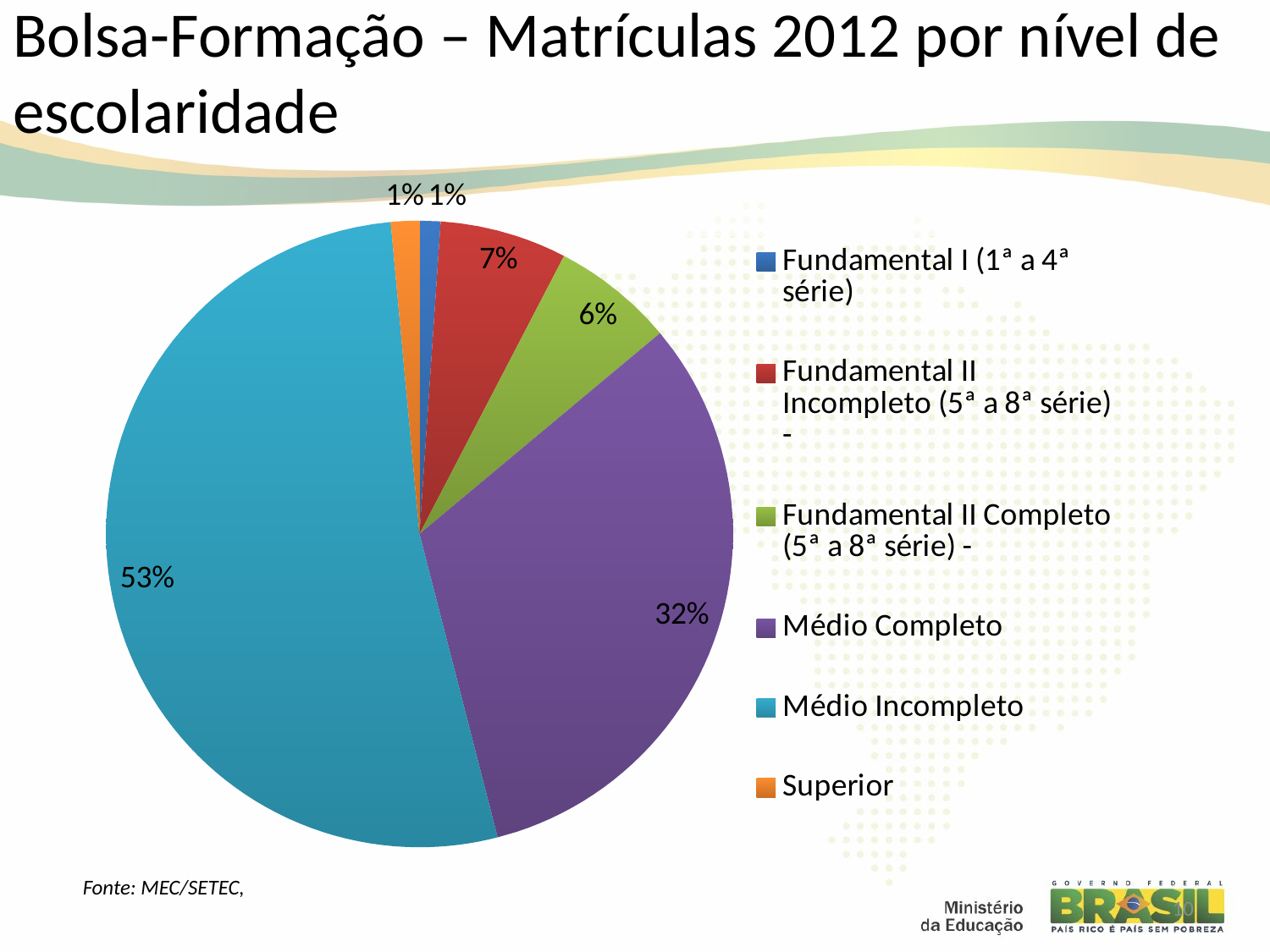
What is the combined share of Médio Completo and Médio Incompleto? 85% What is the difference in percentage points between Médio Incompleto and Médio Completo? 21 What is the value shown for Superior? 1% Which category has the largest slice of the pie? Médio Incompleto What share of the pie does Médio Completo represent? 32% What is the value shown for Fundamental II Completo (5ª a 8ª série)? 6% What kind of chart is shown on the slide? pie chart What colour is the slice for Médio Completo? purple What is the value shown for Fundamental II Incompleto (5ª a 8ª série)? 7% What share of the pie does Médio Incompleto represent? 53% How many categories does the legend list? 6 Which is larger, the slice for Fundamental II Incompleto or the slice for Fundamental II Completo? Fundamental II Incompleto